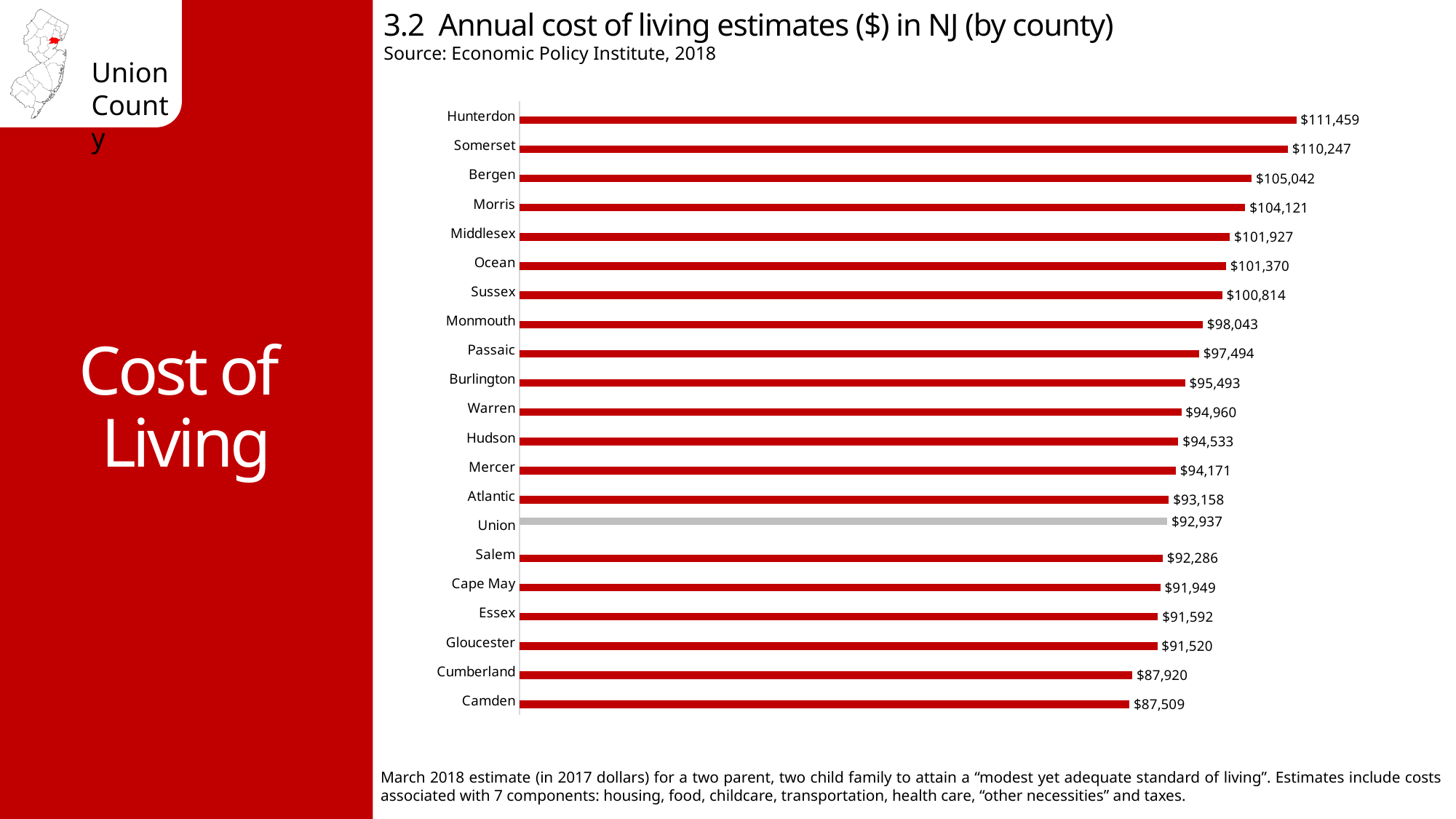
What kind of chart is shown on the slide? Bar chart What is the difference between the cost of living estimates for Union and Salem? $651 What is the annual cost of living estimate for Union county? $92,937 What is the annual cost of living estimate for Bergen county? $105,042 Which county has a higher cost of living estimate, Morris or Monmouth? Morris Which county has the highest annual cost of living estimate? Hunterdon Which county has the lowest annual cost of living estimate? Camden What is the source cited for the chart? Economic Policy Institute, 2018 What is the difference between the cost of living estimates for Hunterdon and Camden? $23,950 Which county's bar is shown in grey rather than red? Union What is the annual cost of living estimate for Camden county? $87,509 How many counties are shown in the chart? 21